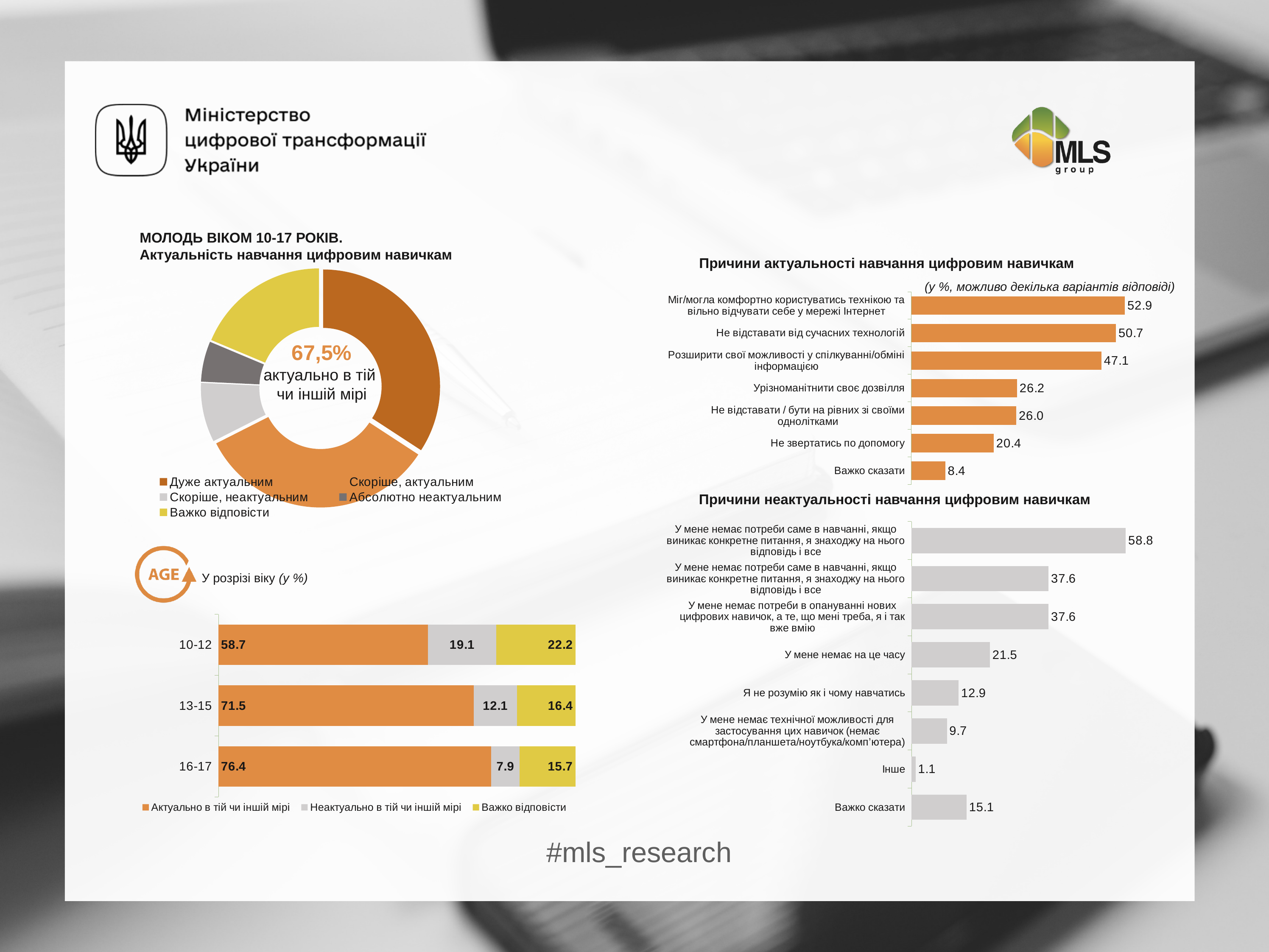
In the chart 'Причини актуальності навчання цифровим навичкам', what is the difference between 'Урізноманітнити своє дозвілля' and 'Не звертатись по допомогу'? 5.8 In the chart 'Причини неактуальності навчання цифровим навичкам', how many categories are shown? 8 In the chart 'Причини неактуальності навчання цифровим навичкам', what is the value for 'У мене немає на це часу'? 21.5 What type of chart is the top-left chart titled 'Актуальність навчання цифровим навичкам'? Donut (pie) chart In the chart 'Причини актуальності навчання цифровим навичкам', which category has the lowest value? Важко сказати In the age breakdown chart 'У розрізі віку (у %)', does the share of 'Актуально в тій чи іншій мірі' rise or fall as the age group increases from 10-12 to 16-17? rise In the age breakdown chart 'У розрізі віку (у %)', what is the value of 'Актуально в тій чи іншій мірі' for the 16-17 age group? 76.4 In the chart 'Причини актуальності навчання цифровим навичкам', how many categories are shown? 7 In the chart 'Причини неактуальності навчання цифровим навичкам', which is larger: 'Я не розумію як і чому навчатись' or 'Важко сказати'? Важко сказати In the chart 'Причини актуальності навчання цифровим навичкам', what is the value for 'Не відставати від сучасних технологій'? 50.7 In the chart 'Причини неактуальності навчання цифровим навичкам', which category has the lowest value? Інше In the age breakdown chart 'У розрізі віку (у %)', how many series does the legend list? 3